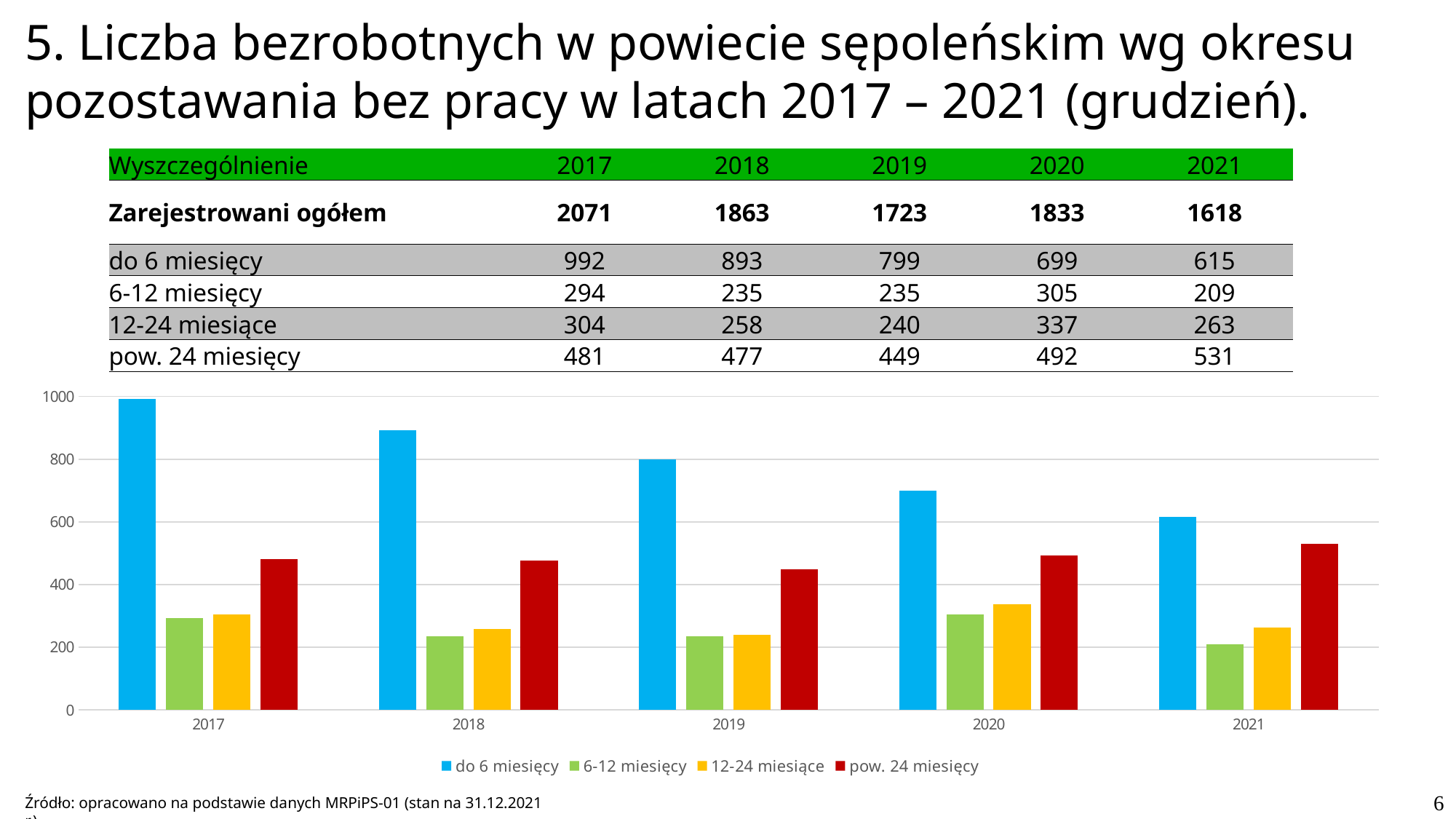
How many years are shown on the x axis of the chart? 5 Which colour represents 'pow. 24 miesięcy' in the chart? red What is the value for 'pow. 24 miesięcy' in 2021? 531 What is the difference between the 'do 6 miesięcy' values for 2017 and 2021? 377 In which year is the value for 'do 6 miesięcy' the lowest? 2021 What kind of chart is shown on the slide? bar chart In which year is the value for 'pow. 24 miesięcy' the highest? 2021 How many series does the chart legend list? 4 Which is larger in 2020: '12-24 miesiące' or '6-12 miesięcy'? 12-24 miesiące What is the value for '6-12 miesięcy' in 2020? 305 Does the value for 'do 6 miesięcy' rise or fall from 2017 to 2021? fall What is the value for 'do 6 miesięcy' in 2017? 992